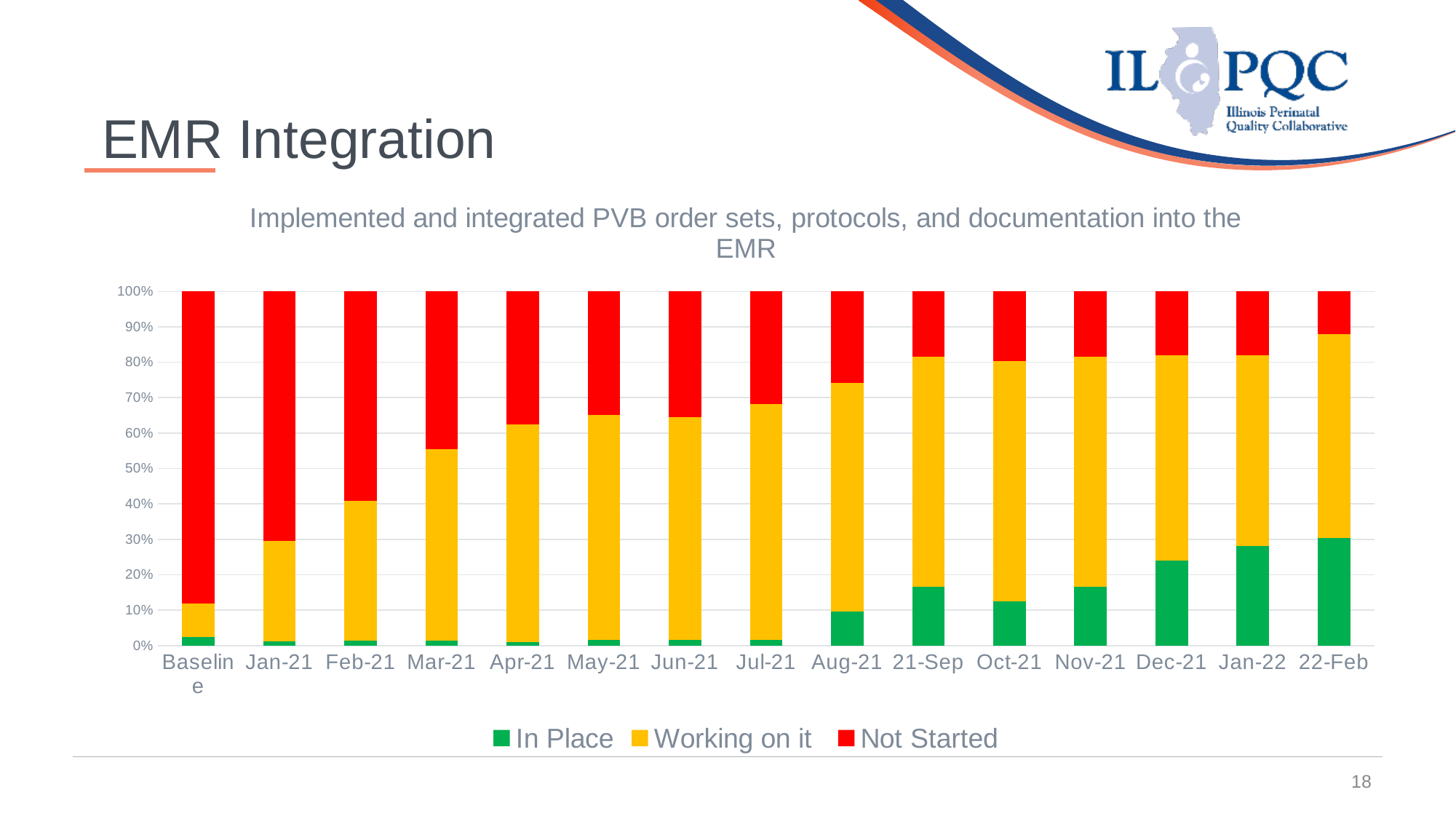
Which colour represents the 'Not Started' series in the chart? Red What kind of chart is shown on the slide? Stacked bar chart Is the 'Not Started' value for Baseline greater or less than 80%? greater Which category has the largest 'Not Started' share? Baseline How many categories are shown along the x axis of the chart? 15 Is the 'In Place' value for 22-Feb greater or less than 20%? greater Which category has the smallest 'Not Started' share? 22-Feb Is the 'Not Started' value for 22-Feb greater or less than 20%? less Does the 'In Place' share generally rise or fall from Baseline to 22-Feb? Rise What are the three series named in the chart's legend? In Place, Working on it, Not Started Which is larger, the 'In Place' share for Dec-21 or for Aug-21? Dec-21 How many series does the chart's legend list? 3